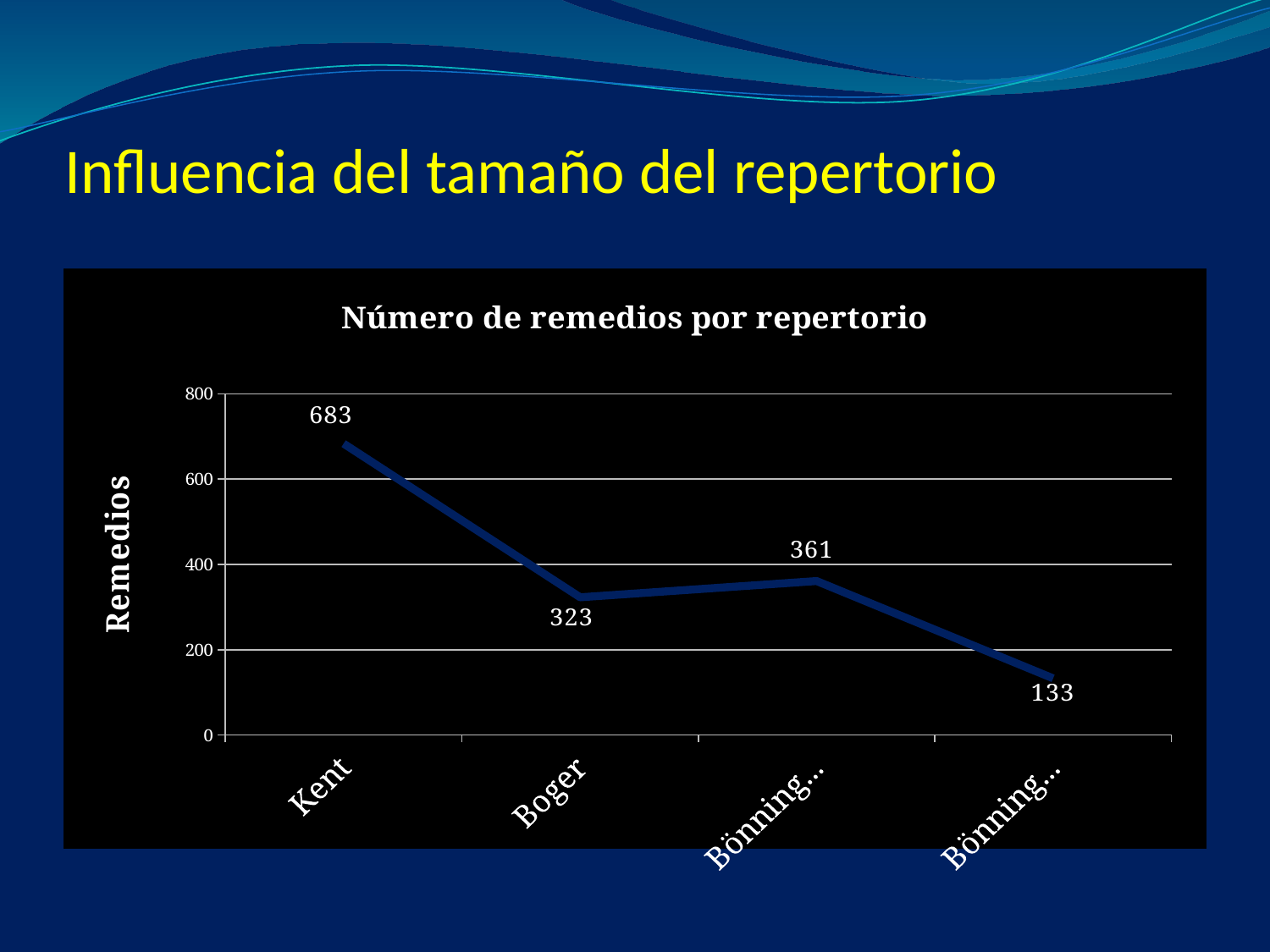
How many repertorios are plotted on the chart? 4 Is the value for Boger larger or smaller than the value for the third point on the line? smaller What is the number of remedios for Kent? 683 What is the lowest value plotted on the chart? 133 Which repertorio has the highest number of remedios? Kent What is the difference between the values for Kent and Boger? 360 Overall, do the values rise or fall from the first point to the last point along the x axis? fall What kind of chart is shown on the slide? line chart What is the number of remedios for Boger? 323 What is the title of the chart? Número de remedios por repertorio What value is shown for the third point on the line (the one after Boger)? 361 Is the value for Kent greater or less than 600? greater